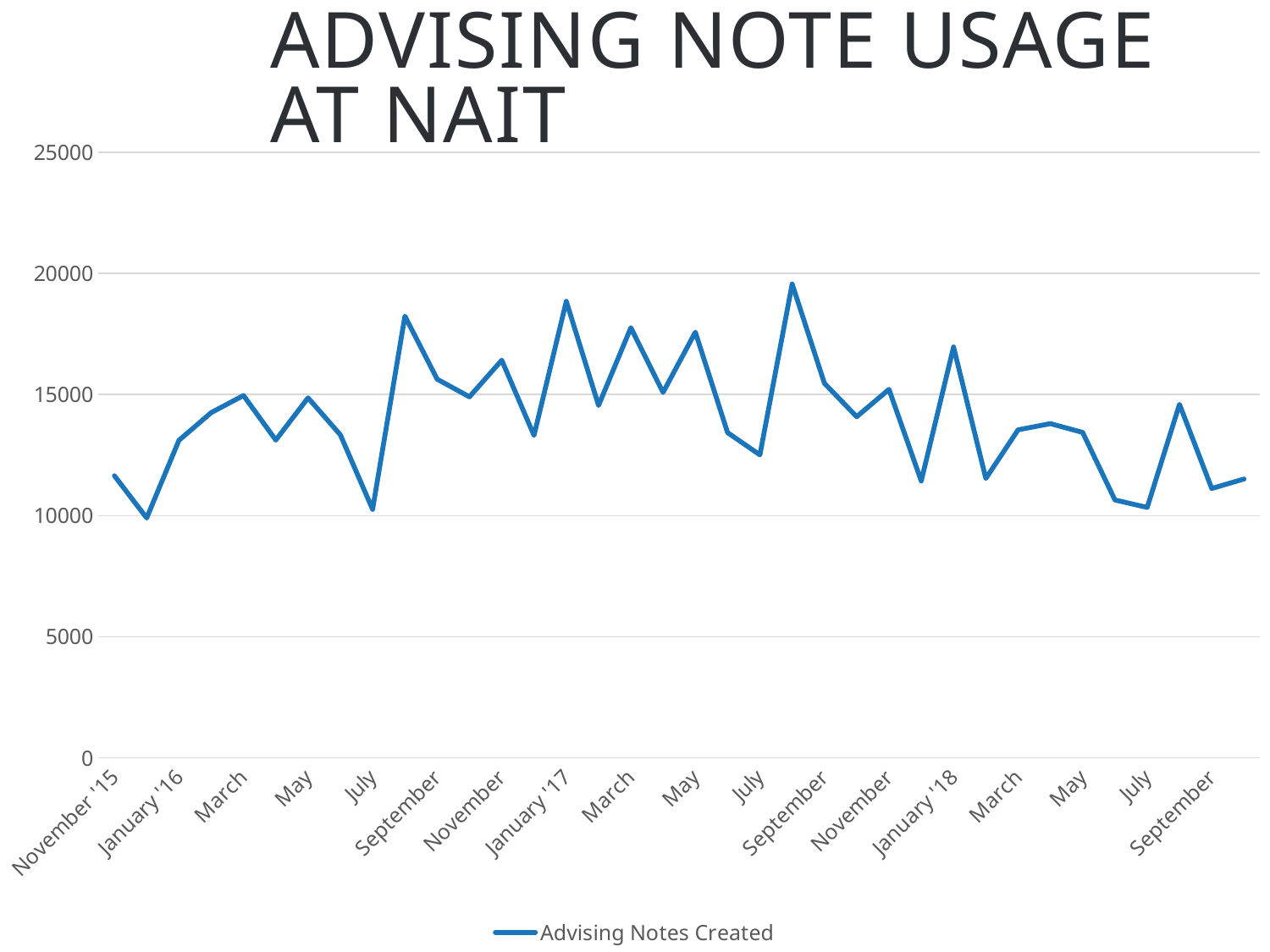
What is the name of the series shown in the legend? Advising Notes Created Is the value for September '17 greater or less than 20000? less Is the value for September '17 greater or less than 15000? greater Which is larger, the value for September '17 or the value for January '18? January '18 Is the value for September '16 greater or less than 15000? greater Which labeled month has the highest value for Advising Notes Created? January '17 What kind of chart is shown on the slide? line chart What is the title of the chart? ADVISING NOTE USAGE AT NAIT How many series does the legend list? 1 Does the value rise or fall from July '16 to September '16? rise